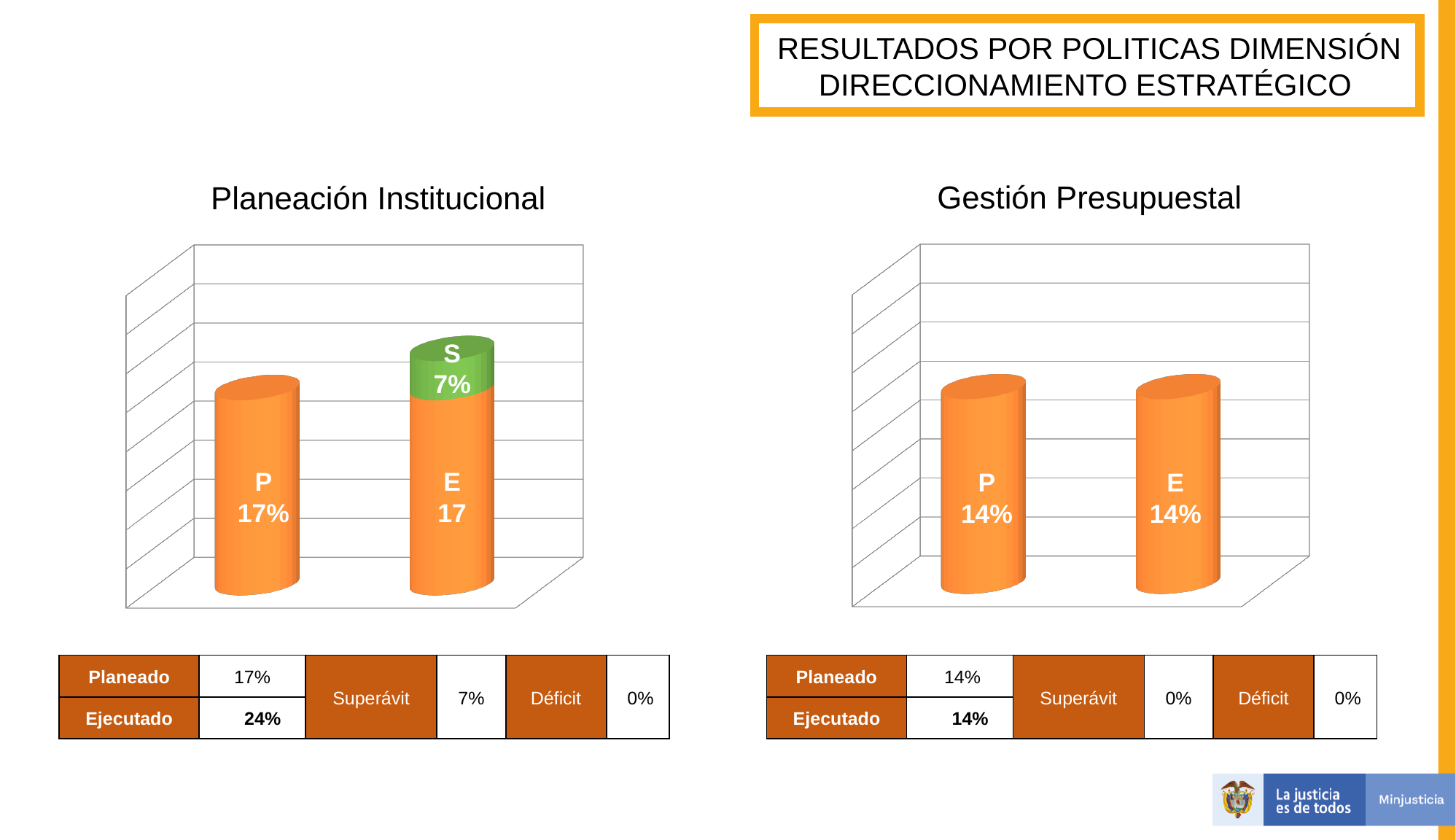
In the Planeación Institucional chart, what value is printed on the orange E segment? 17 In the Gestión Presupuestal chart, what value is shown for the P bar? 14% In the Planeación Institucional chart, what value is shown for the green S segment on top of the E bar? 7% In the Planeación Institucional chart, what is the total of the stacked E bar (E plus S)? 24% In the Planeación Institucional chart, what is the difference between the E segment value and the S segment value? 10 What kind of chart is the Planeación Institucional chart? Bar chart In the Planeación Institucional chart, what value is shown for the P bar? 17% What is the title of the chart on the right side of the slide? Gestión Presupuestal How many bars are plotted in the Gestión Presupuestal chart? 2 In the Planeación Institucional chart, which bar is taller overall, P or E? E In the Gestión Presupuestal chart, what value is shown for the E bar? 14% In the Planeación Institucional chart, what colour is the S segment? Green